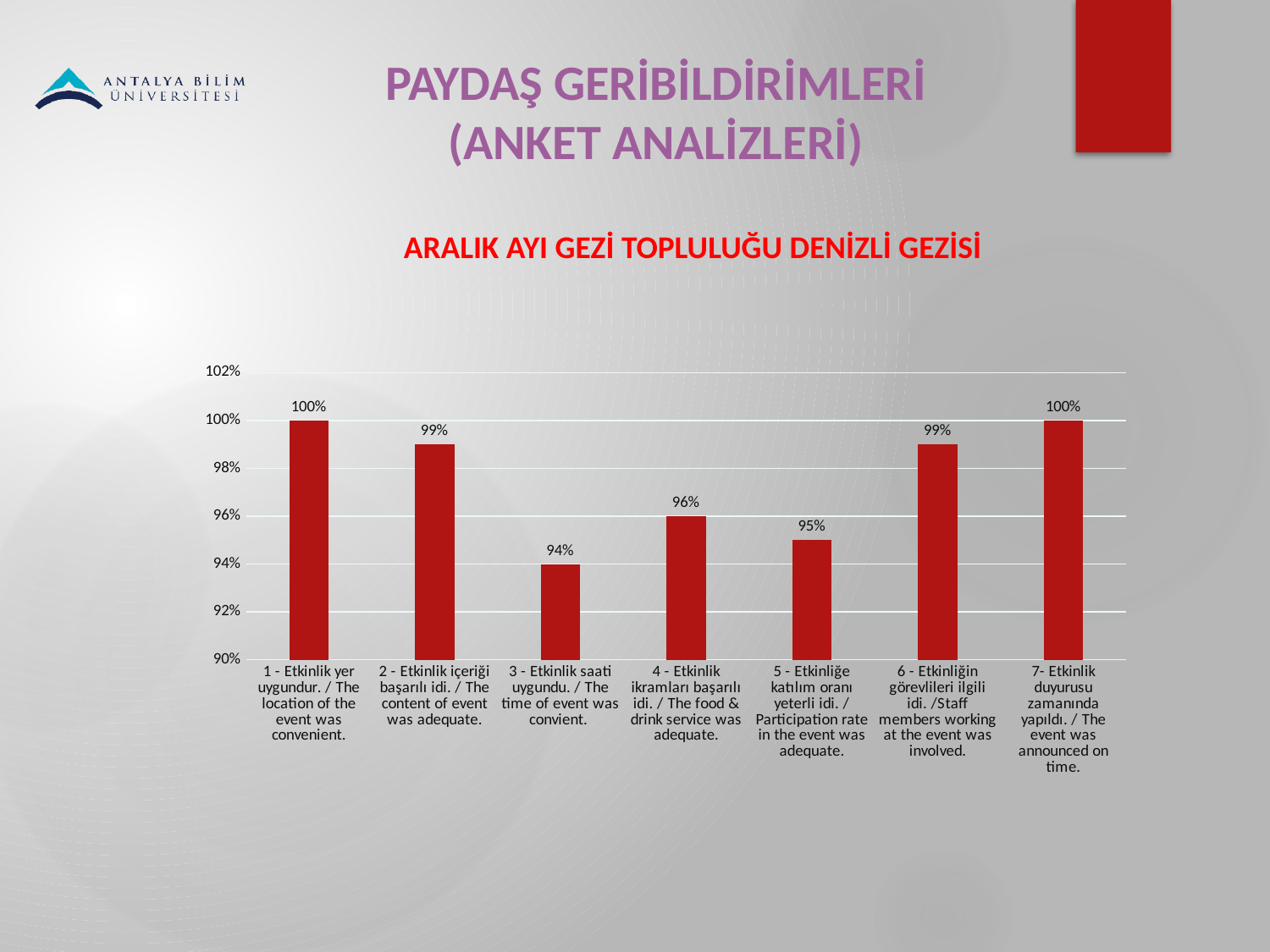
What colour are the bars in the chart? red How many categories are shown in the chart? 7 What is the value for item 4 (Etkinlik ikramları başarılı idi / The food & drink service was adequate)? 96% What is the value for item 5 (Etkinliğe katılım oranı yeterli idi / Participation rate in the event was adequate)? 95% What is the difference between the value for item 6 (staff members working at the event was involved) and item 5 (participation rate in the event was adequate)? 4% What is the difference between the value for item 1 (location of the event was convenient) and item 3 (time of event was convient)? 6% What is the value for item 3 (Etkinlik saati uygundu / The time of event was convient)? 94% What is the title of the chart? ARALIK AYI GEZİ TOPLULUĞU DENİZLİ GEZİSİ What kind of chart is shown on the slide? bar chart Which item has the lowest value? 3 - Etkinlik saati uygundu. / The time of event was convient. Which is larger: the value for item 2 (content of event was adequate) or item 4 (food & drink service was adequate)? 2 - Etkinlik içeriği başarılı idi. / The content of event was adequate. Is the value for item 5 (participation rate in the event was adequate) greater or less than 98%? less